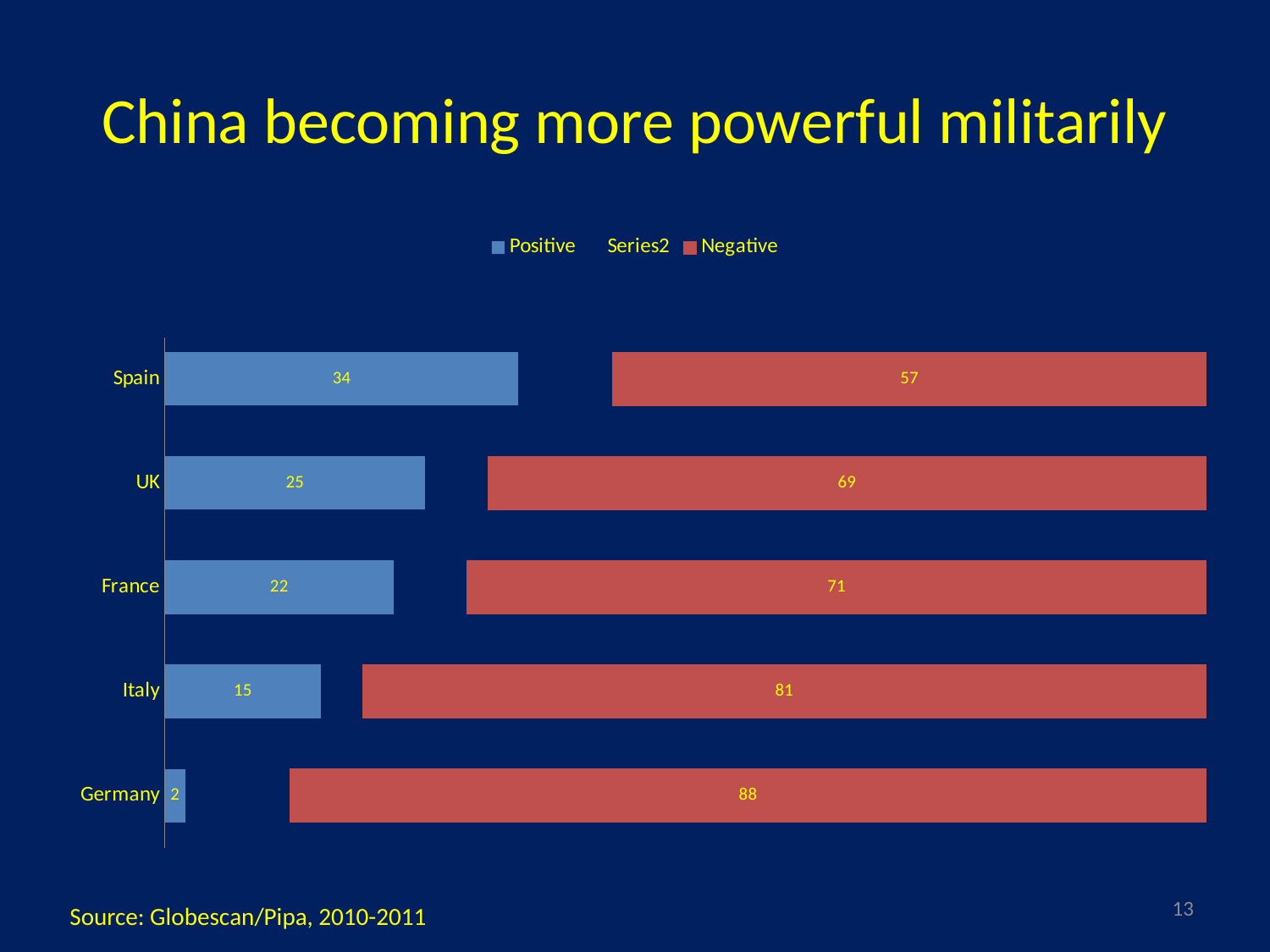
What is the Positive value for Italy? 15 What is the Positive value for Spain? 34 Which country has the lowest Positive value? Germany Which is larger, the Negative value for Italy or the Negative value for the UK? Italy Which country has the highest Positive value? Spain How many countries are shown in the chart? 5 Which country has the highest Negative value? Germany What type of chart is shown on the slide? Bar chart What is the Negative value for the UK? 69 How many series does the legend list? 3 What is the Negative value for Germany? 88 What is the difference between the Negative and Positive values for France? 49